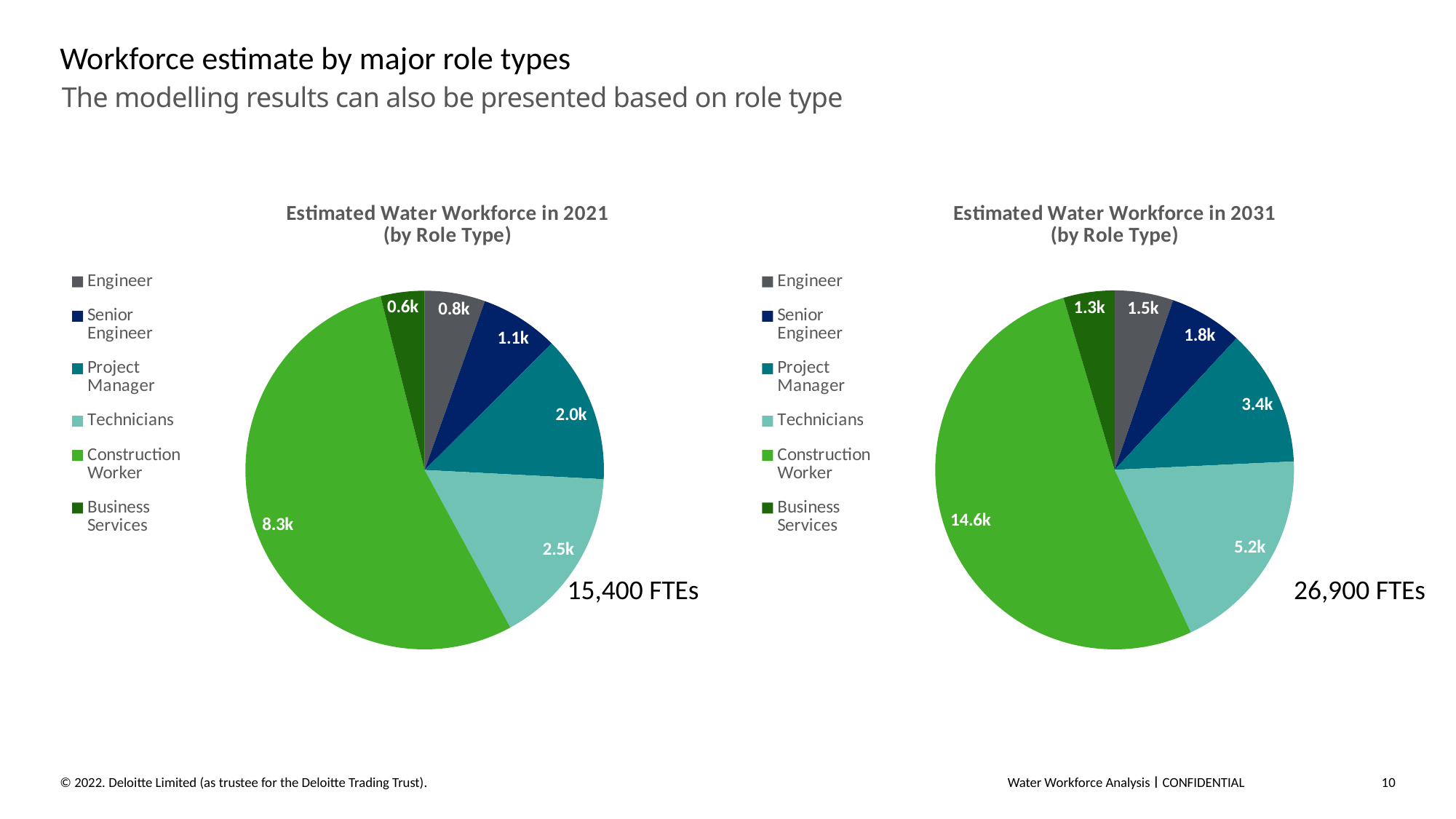
In the 'Estimated Water Workforce in 2021' chart, which is larger: Senior Engineer or Engineer? Senior Engineer What total number of FTEs is shown next to the 'Estimated Water Workforce in 2021' chart? 15,400 FTEs What total number of FTEs is shown next to the 'Estimated Water Workforce in 2031' chart? 26,900 FTEs What type of chart is used for 'Estimated Water Workforce in 2031 (by Role Type)'? Pie chart How many role types are shown in the 'Estimated Water Workforce in 2021' chart? 6 In the 'Estimated Water Workforce in 2021' chart, what is the value for Project Manager? 2.0k In the 'Estimated Water Workforce in 2021' chart, what is the value for Construction Worker? 8.3k In the 'Estimated Water Workforce in 2031' chart, what is the difference between the Technicians value and the Project Manager value? 1.8k In the 'Estimated Water Workforce in 2031' chart, which role type has the largest slice? Construction Worker In the 'Estimated Water Workforce in 2021' chart, which role type has the smallest slice? Business Services In the 'Estimated Water Workforce in 2031' chart, what is the value for Business Services? 1.3k In the 'Estimated Water Workforce in 2031' chart, what is the value for Technicians? 5.2k